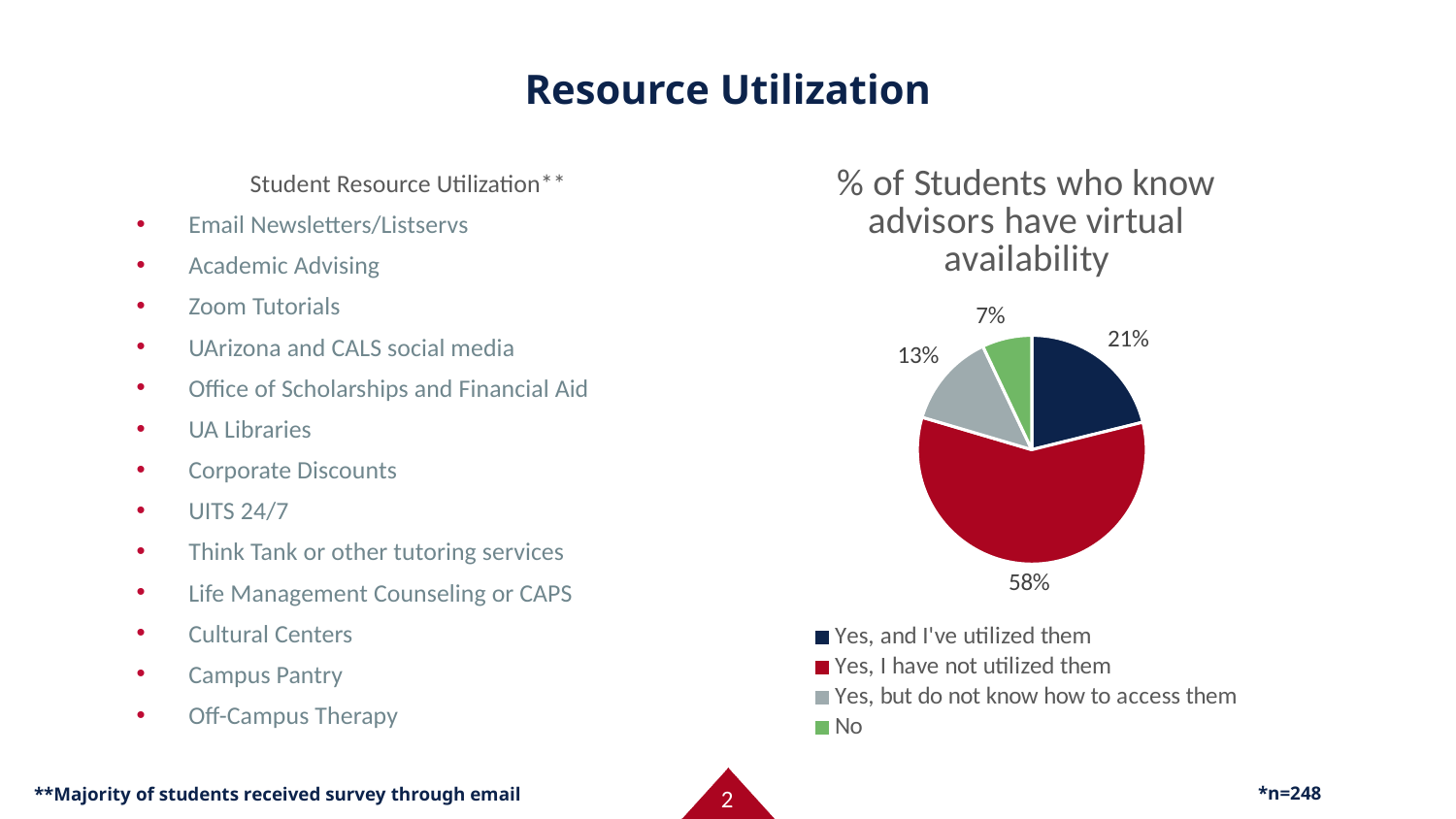
What is the title of the chart? % of Students who know advisors have virtual availability What colour is the slice for "Yes, I have not utilized them"? red Which response has the largest share of the pie? Yes, I have not utilized them What kind of chart is shown on the slide? pie chart What percentage of students answered "Yes, I have not utilized them"? 58% What percentage of students answered "Yes, and I've utilized them"? 21% What percentage of students answered "No"? 7% Which response has the smallest share of the pie? No How many slices does the pie chart have? 4 What percentage of students answered "Yes, but do not know how to access them"? 13% What is the difference in percentage points between "Yes, I have not utilized them" and "Yes, and I've utilized them"? 37 Which is larger: the share for "Yes, but do not know how to access them" or the share for "No"? Yes, but do not know how to access them